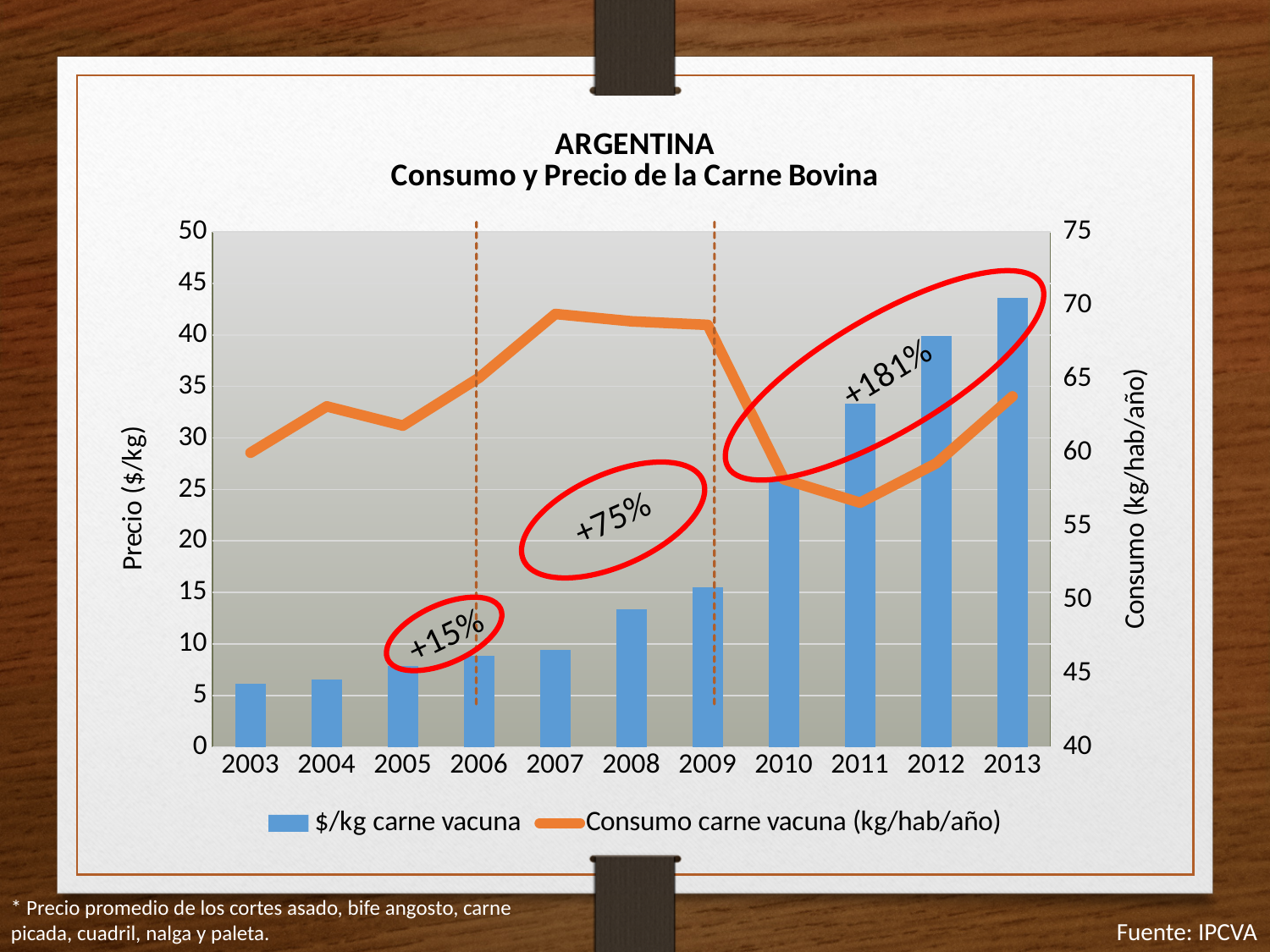
Which year has the highest bar for $/kg carne vacuna? 2013 Do the $/kg carne vacuna bars rise or fall from 2003 to 2013? rise Is the Consumo carne vacuna value for 2007 greater or less than 65 kg/hab/año? greater What kind of chart is shown on the slide? A combined bar and line chart How many series does the legend list? 2 Is the $/kg carne vacuna value for 2013 greater or less than 40? greater Is the $/kg carne vacuna value for 2003 greater or less than 10? less Which year has the lowest value on the Consumo carne vacuna line? 2011 Which year has the lowest bar for $/kg carne vacuna? 2003 Which is larger, the $/kg carne vacuna bar for 2010 or for 2008? 2010 How many years are shown on the x axis of the chart? 11